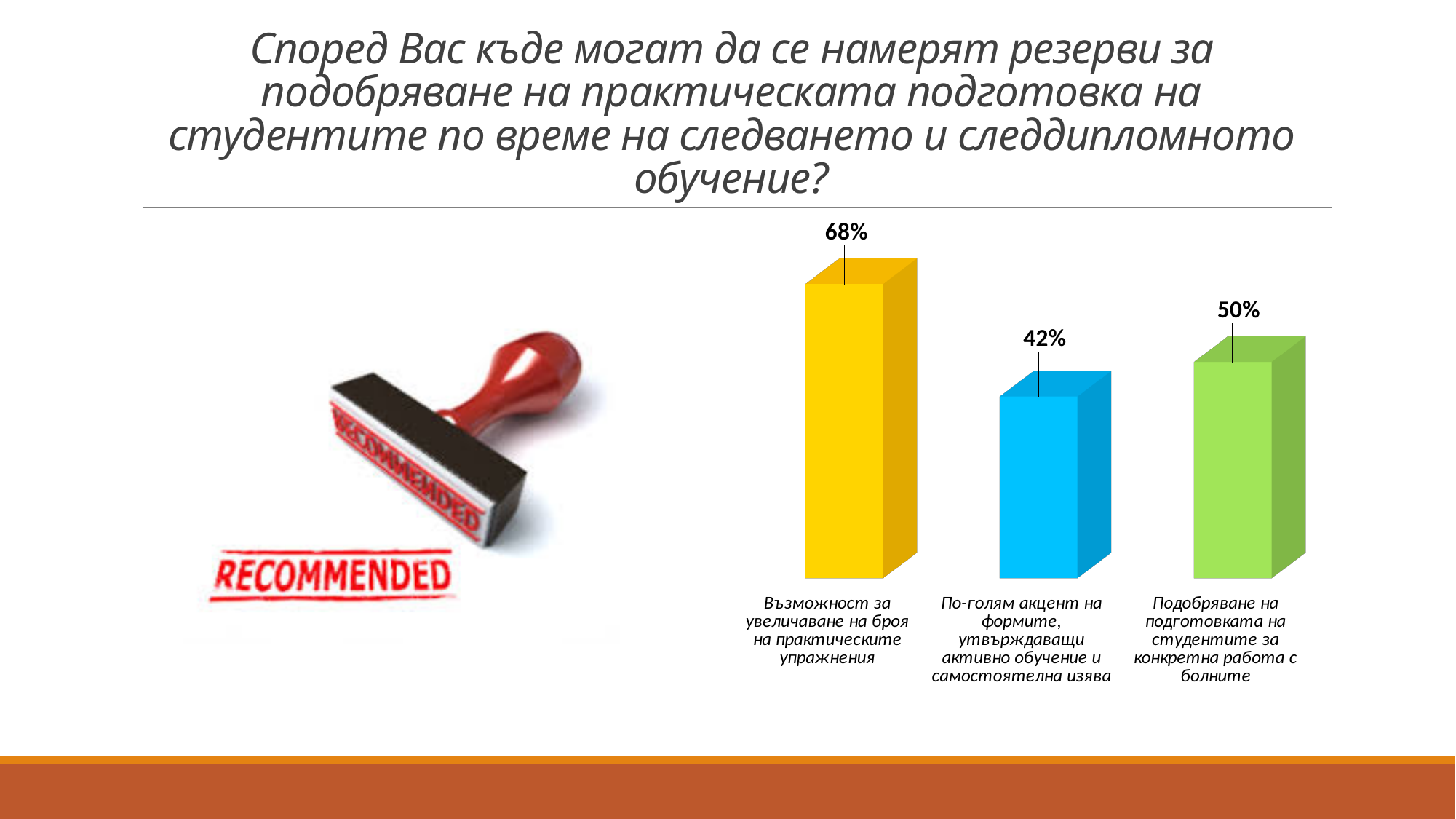
What is the value for "По-голям акцент на формите, утвърждаващи активно обучение и самостоятелна изява"? 42% Which category has the lowest value? По-голям акцент на формите, утвърждаващи активно обучение и самостоятелна изява Which category has the highest value? Възможност за увеличаване на броя на практическите упражнения What colour is the bar for "Възможност за увеличаване на броя на практическите упражнения"? Yellow What is the value for "Подобряване на подготовката на студентите за конкретна работа с болните"? 50% What is the difference between the values for "Подобряване на подготовката на студентите за конкретна работа с болните" and "По-голям акцент на формите, утвърждаващи активно обучение и самостоятелна изява"? 8% How many categories are shown in the chart? 3 What is the difference between the values for "Възможност за увеличаване на броя на практическите упражнения" and "По-голям акцент на формите, утвърждаващи активно обучение и самостоятелна изява"? 26% What is the value for "Възможност за увеличаване на броя на практическите упражнения"? 68% Which is larger: the value for "Подобряване на подготовката на студентите за конкретна работа с болните" or the value for "По-голям акцент на формите, утвърждаващи активно обучение и самостоятелна изява"? Подобряване на подготовката на студентите за конкретна работа с болните What kind of chart is shown on the slide? Bar chart What colour is the bar for "По-голям акцент на формите, утвърждаващи активно обучение и самостоятелна изява"? Blue